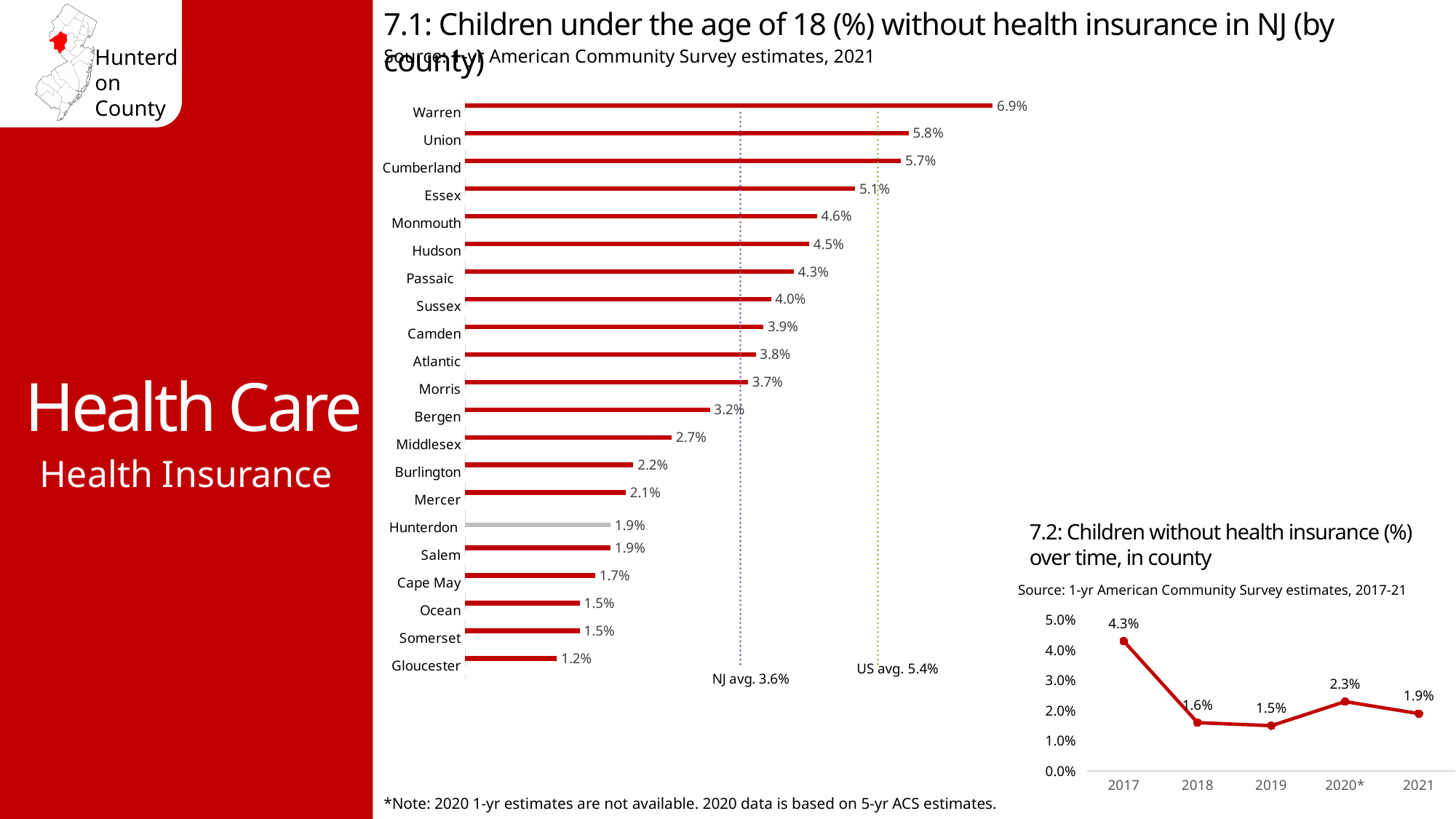
In chart 7.1 (children under 18 without health insurance by county), what is the difference between Warren and Gloucester? 5.7% In chart 7.1 (children under 18 without health insurance by county), what is the value for Cumberland? 5.7% In chart 7.2 (children without health insurance over time, in county), what kind of chart is it? Line chart In chart 7.1 (children under 18 without health insurance by county), what is the NJ average shown by the dotted line? 3.6% In chart 7.1 (children under 18 without health insurance by county), what is the value for Hunterdon? 1.9% In chart 7.1 (children under 18 without health insurance by county), which county has the highest value? Warren In chart 7.1 (children under 18 without health insurance by county), how many counties are shown? 21 In chart 7.1 (children under 18 without health insurance by county), which is larger, the value for Essex or the value for Morris? Essex In chart 7.1 (children under 18 without health insurance by county), which county has the lowest value? Gloucester In chart 7.2 (children without health insurance over time, in county), what is the difference between the 2017 and 2021 values? 2.4% In chart 7.2 (children without health insurance over time, in county), which year has the lowest value? 2019 In chart 7.2 (children without health insurance over time, in county), what is the value for 2017? 4.3%